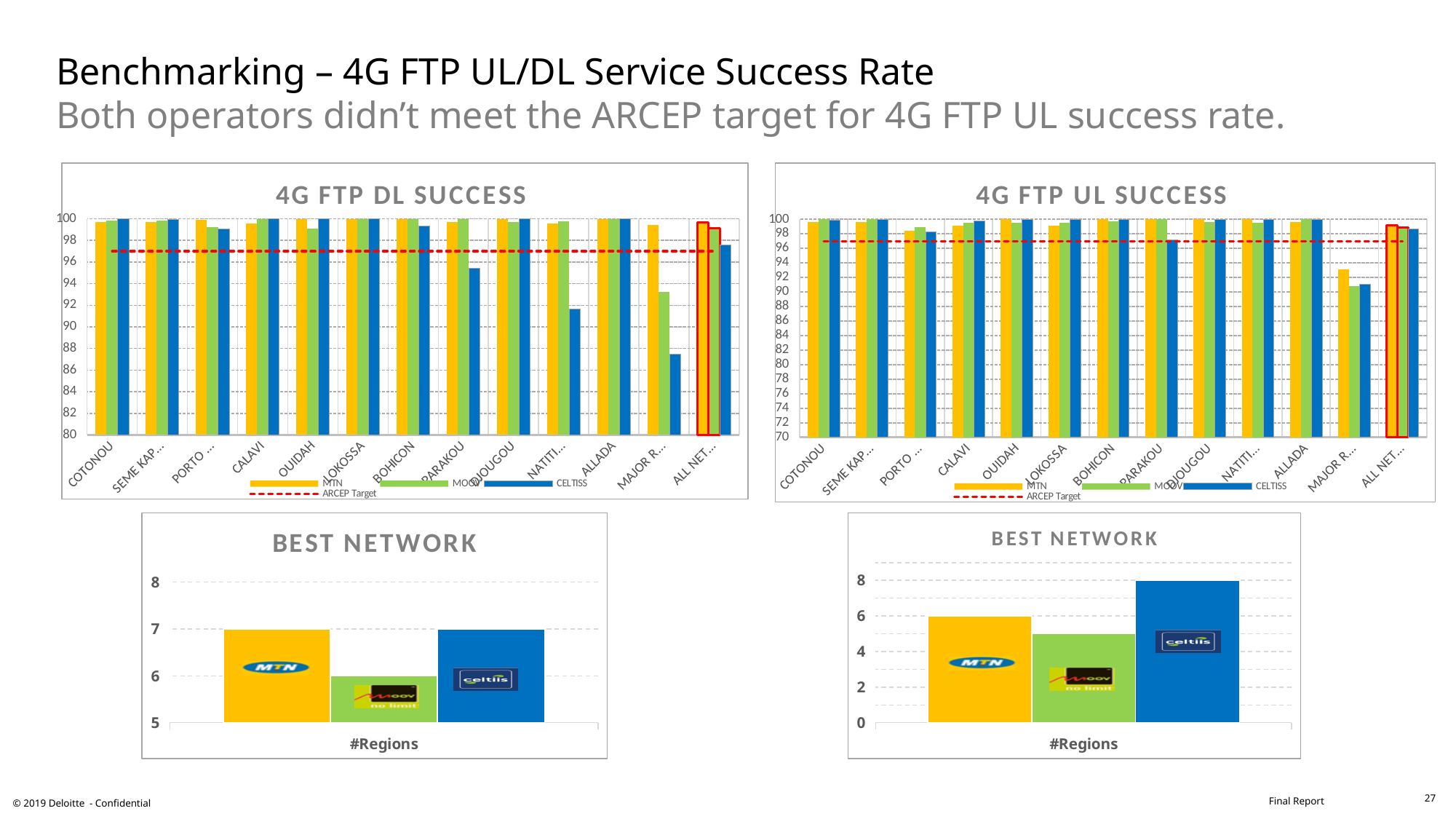
In the "4G FTP DL SUCCESS" chart, which is larger for MAJOR R..., the MTN bar or the CELTIIS bar? MTN In the bottom-left "BEST NETWORK" chart, which operator has the lowest bar? MOOV How many entries does the legend of the "4G FTP DL SUCCESS" chart list? 4 How many categories are shown on the x axis of the "4G FTP UL SUCCESS" chart? 13 In the bottom-right "BEST NETWORK" chart, is the value for MOOV greater or less than 6? less In the bottom-left "BEST NETWORK" chart, what is the value for MOOV? 6 In the "4G FTP DL SUCCESS" chart, is the CELTIIS value for MAJOR R... greater or less than 90? less In the "4G FTP DL SUCCESS" chart, is the CELTIIS value for NATITI... greater or less than 94? less In the bottom-right "BEST NETWORK" chart, which operator has the highest bar? CELTIIS In the "4G FTP UL SUCCESS" chart, how is the ARCEP Target shown? As a red dashed line What kind of chart is the "4G FTP DL SUCCESS" chart? Bar chart